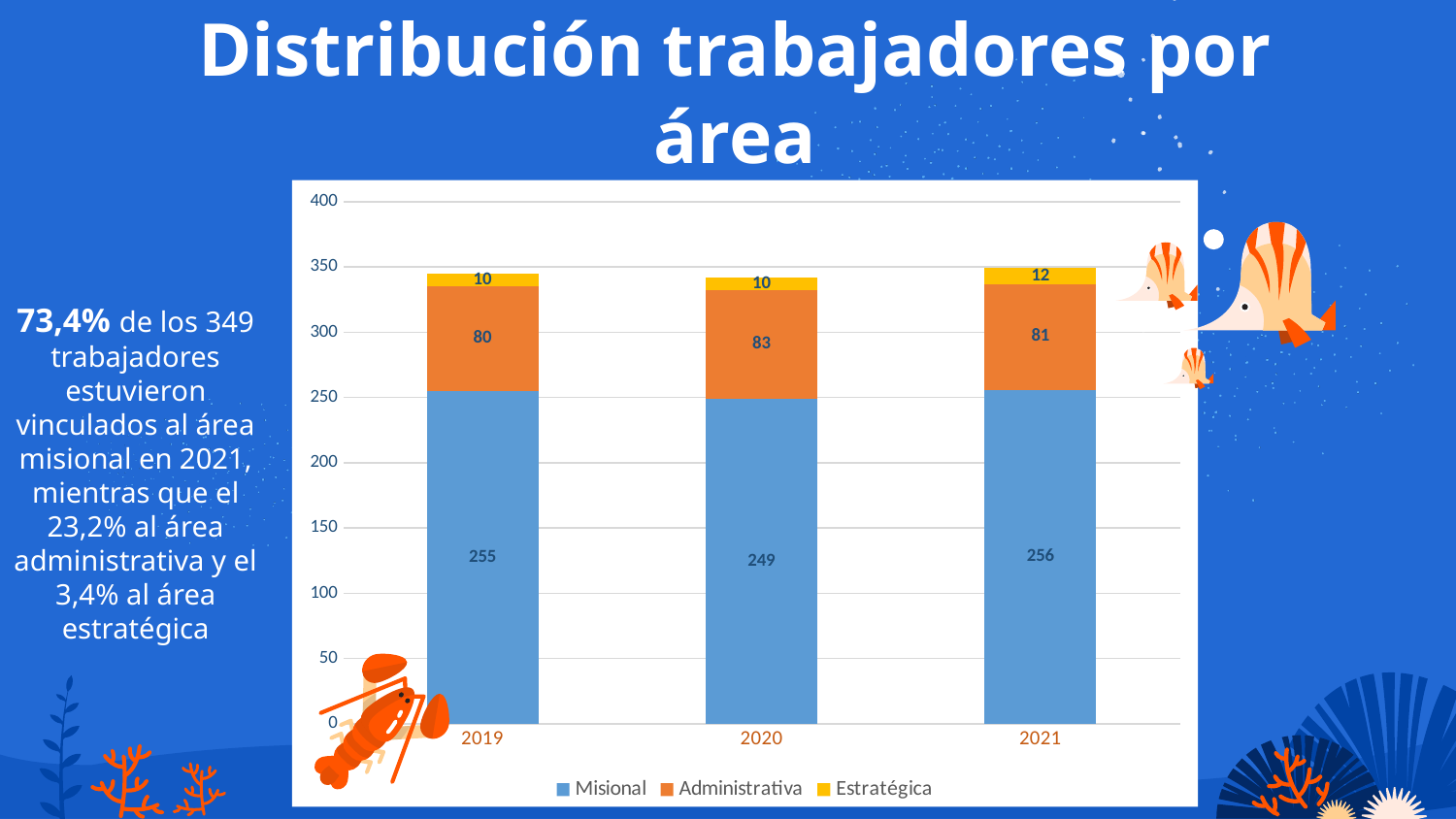
What kind of chart is shown on the slide? Stacked bar chart What is the value for Misional in 2019? 255 What is the value for Estratégica in 2021? 12 Which year has the lowest Misional value? 2020 Which year has the highest Misional value? 2021 Which is larger, the Administrativa value for 2020 or for 2021? 2020 What is the total of the stacked bar for 2019? 345 How many years are shown on the x axis? 3 What is the difference between the Misional values for 2021 and 2020? 7 What is the value for Administrativa in 2020? 83 How many series does the legend list? 3 What is the total of the stacked bar for 2021? 349